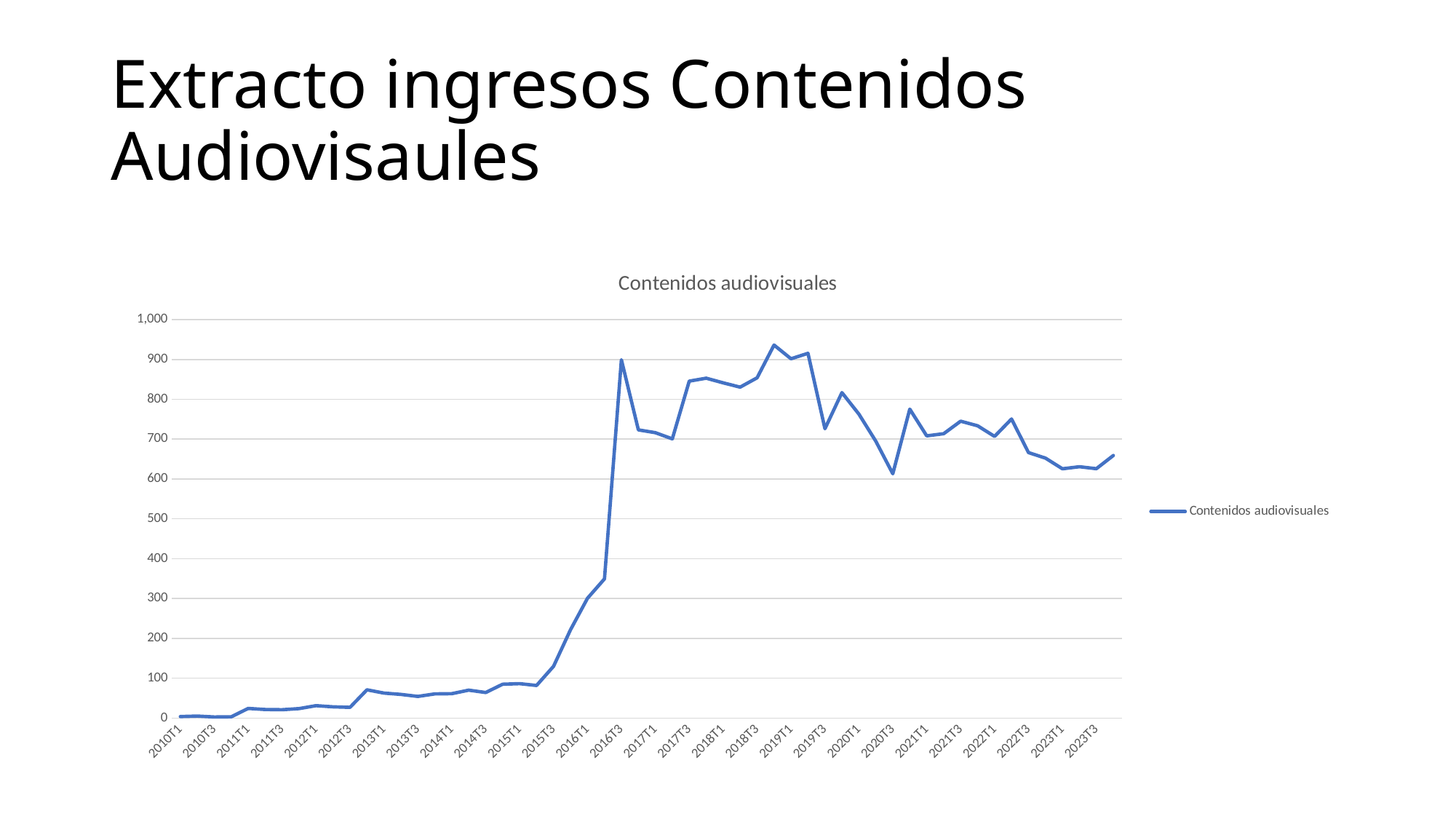
Is the value for 2016T3 greater or less than 800? greater Is the value for 2015T3 greater or less than 200? less Do the values rise or fall along the x axis from 2010T1 to 2016T3? rise Is the value for 2020T3 greater or less than 700? less How many series does the legend list? 1 Which is larger, the value for 2016T3 or the value for 2017T1? 2016T3 What kind of chart is shown on the slide? line chart What is the title of the chart? Contenidos audiovisuales What colour is the line for Contenidos audiovisuales? blue